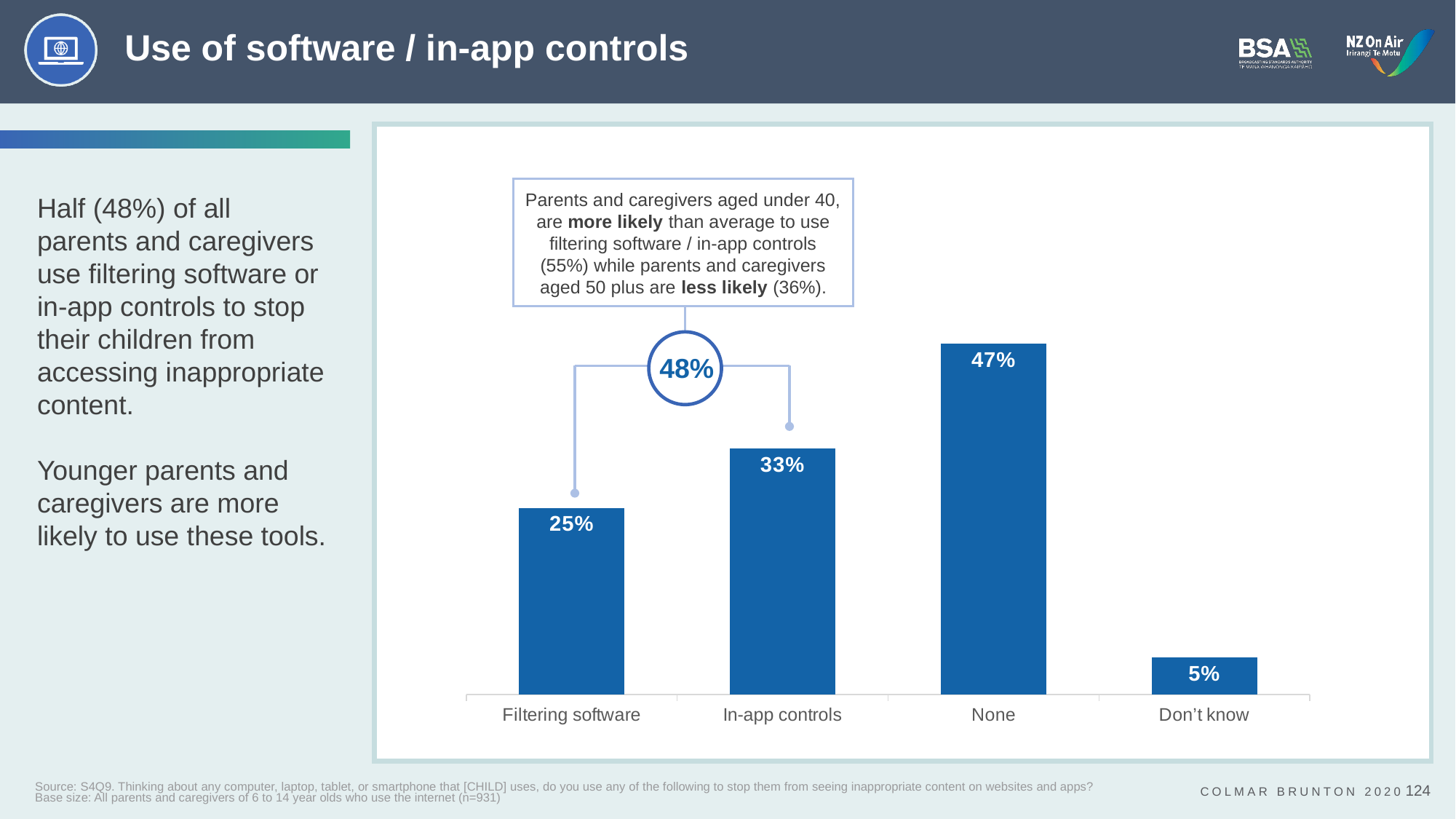
What is the difference between the values for In-app controls and Filtering software? 8% How many categories are shown on the chart? 4 What combined percentage is shown in the circle above the Filtering software and In-app controls bars? 48% What is the difference between the values for None and Filtering software? 22% Which category has the highest value? None What percentage of parents and caregivers use filtering software? 25% What is the value shown for In-app controls? 33% What is the value shown for None? 47% What type of chart is shown on the slide? Bar chart What is the value shown for Don't know? 5% Which is larger, the value for In-app controls or the value for Filtering software? In-app controls Which category has the lowest value? Don't know